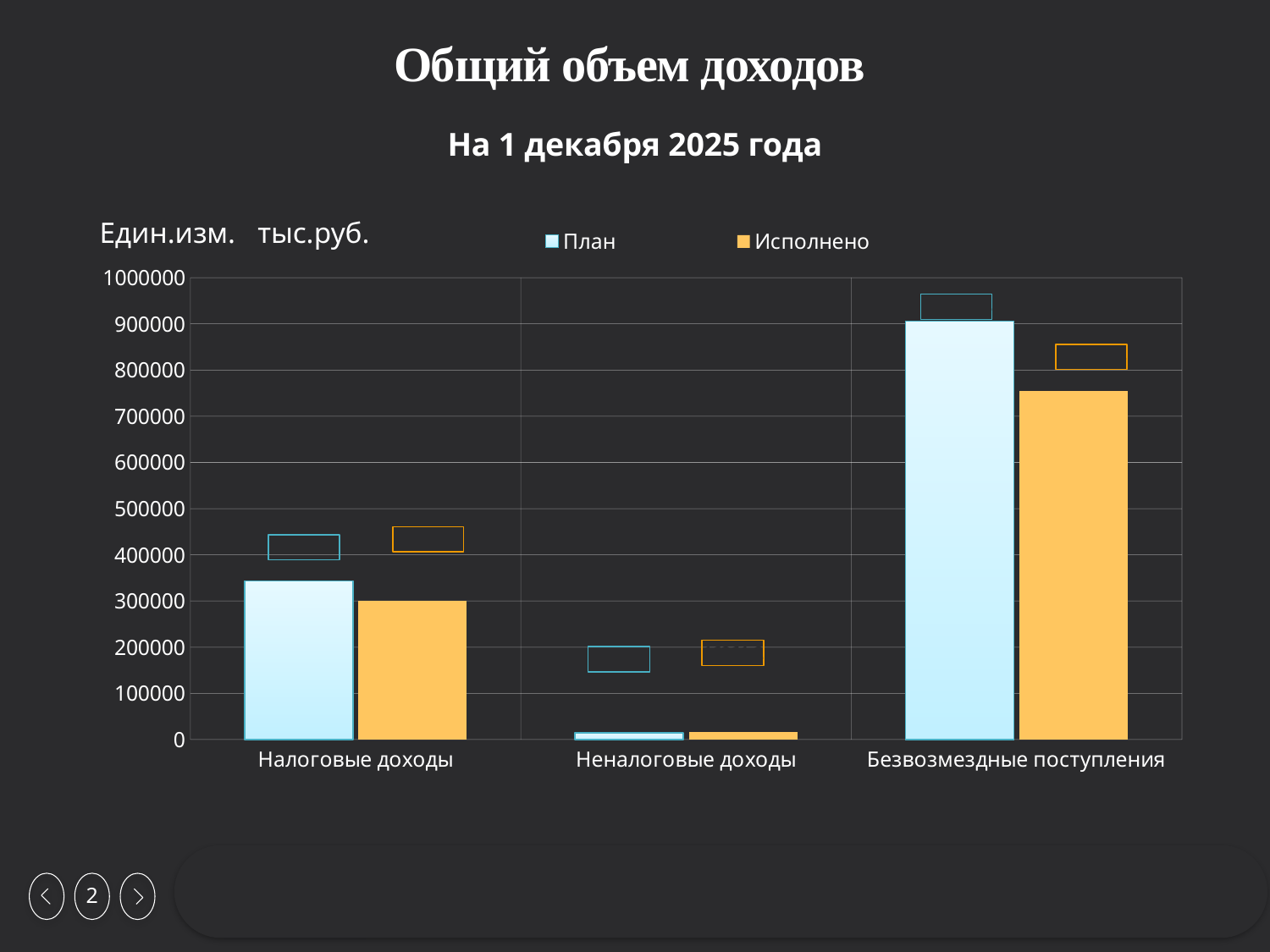
What kind of chart is shown on the slide? bar chart How many categories are shown on the x axis? 3 For Налоговые доходы, which is larger: План or Исполнено? План How many series does the legend list? 2 Is the План value for Налоговые доходы greater or less than 300000? greater What unit of measurement is stated for the chart? тыс.руб. Which category has the highest План value? Безвозмездные поступления Is the Исполнено value for Неналоговые доходы greater or less than 100000? less For Безвозмездные поступления, which is larger: План or Исполнено? План Is the План value for Безвозмездные поступления greater or less than 800000? greater Which category has the lowest Исполнено value? Неналоговые доходы